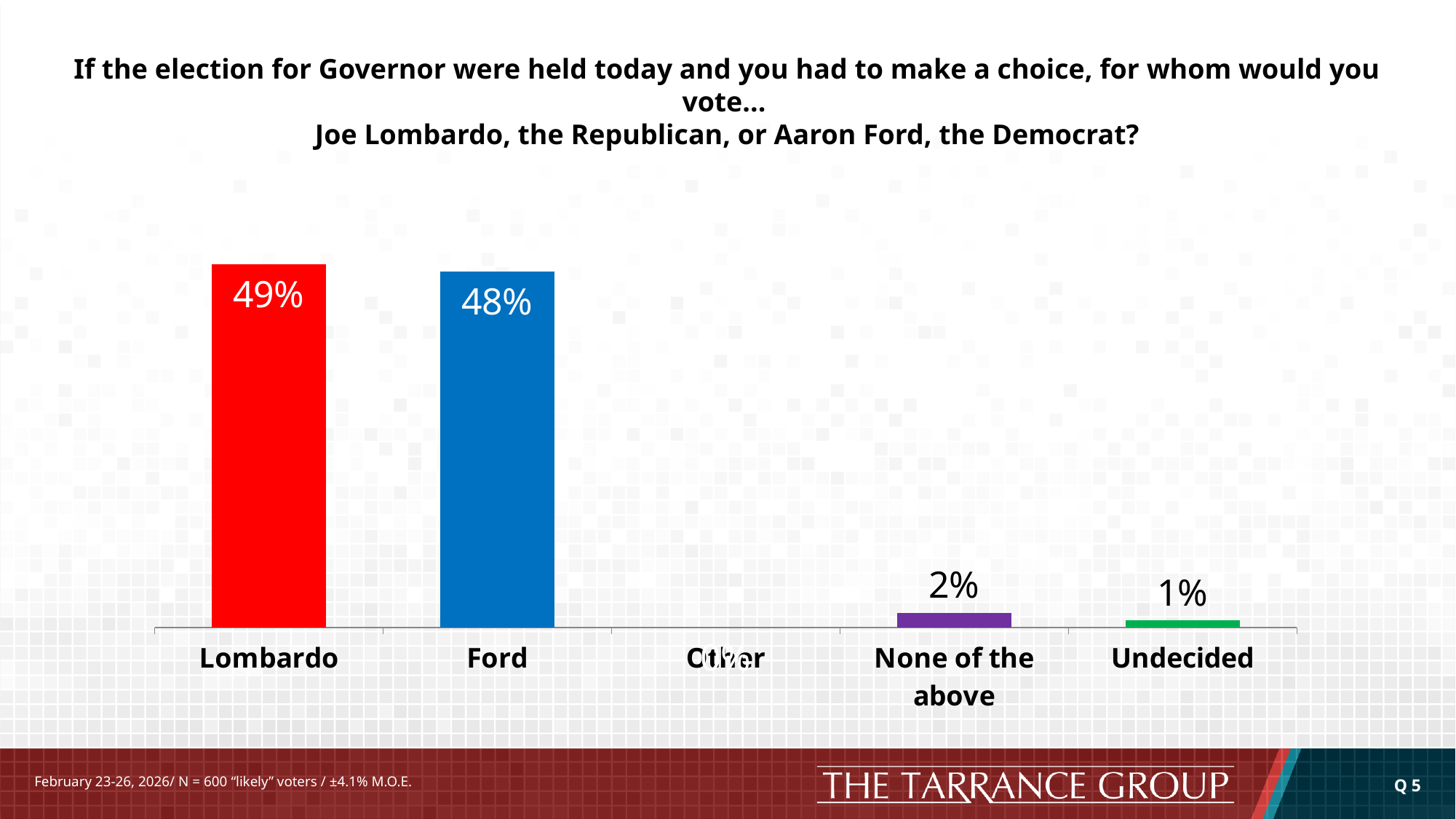
What percentage of voters chose Ford? 48% What kind of chart is shown on the slide? Bar chart What colour is the bar for Lombardo? Red What is the value shown for Undecided? 1% What is the difference between the values for Lombardo and Ford? 1% Which category has the highest value? Lombardo What is the difference between the values for None of the above and Undecided? 1% Which is larger, the value for None of the above or the value for Undecided? None of the above What percentage of voters chose Lombardo? 49% What is the value shown for None of the above? 2% Which is larger, the value for Lombardo or the value for Ford? Lombardo How many categories are shown on the x axis? 5